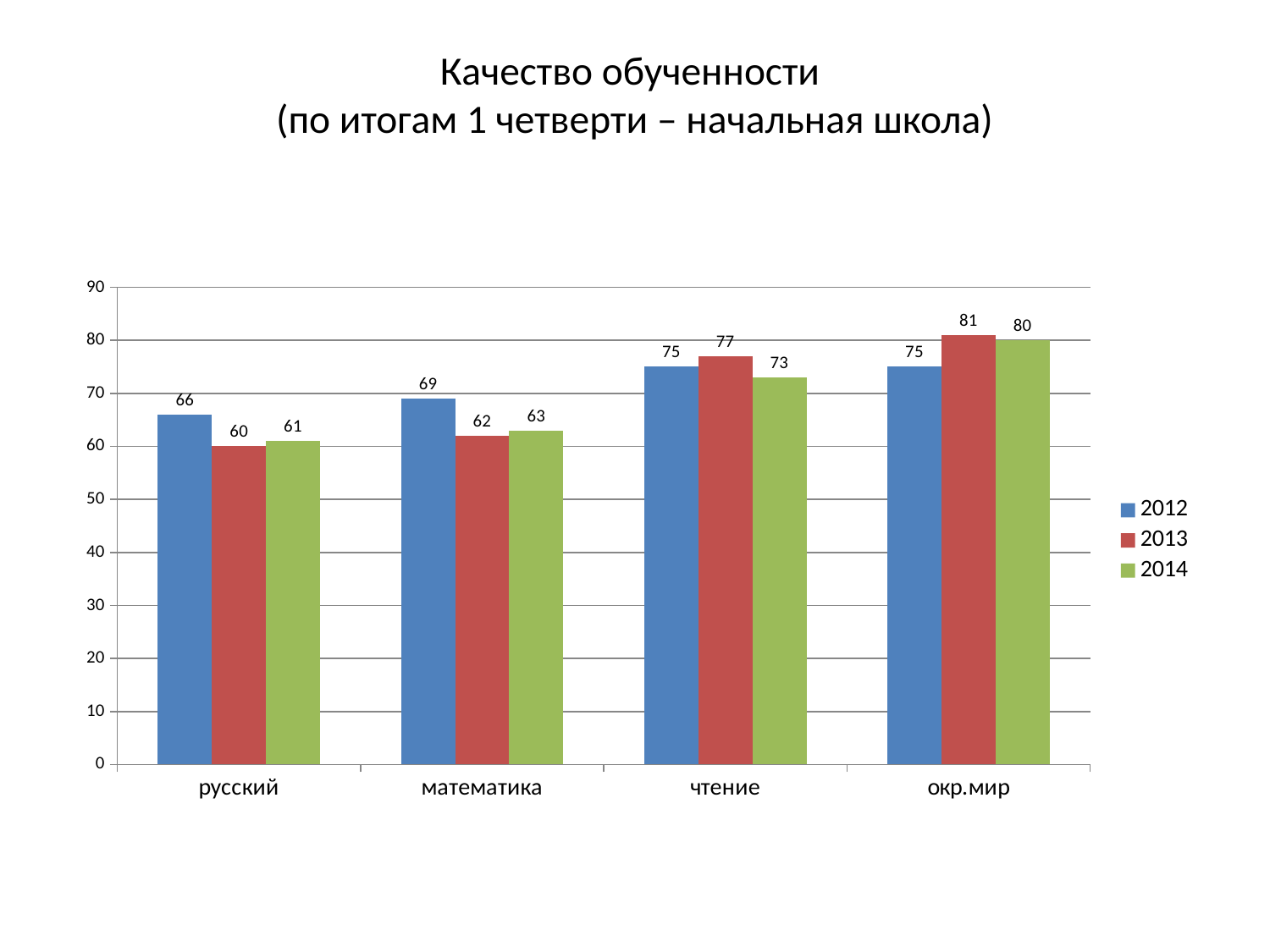
What is the difference between the 2013 and 2012 values for чтение? 2 What is the value for математика in the 2013 series? 62 Which is larger for математика: the 2012 value or the 2014 value? 2012 Do the 2012 values rise or fall from русский to чтение? rise What is the value for русский in the 2012 series? 66 How many categories are shown on the x axis? 4 What is the value for окр.мир in the 2014 series? 80 Which category has the lowest value in the 2014 series? русский Which category has the highest value in the 2013 series? окр.мир What kind of chart is shown on the slide? bar chart What are the series names listed in the legend? 2012, 2013, 2014 How many series does the legend list? 3